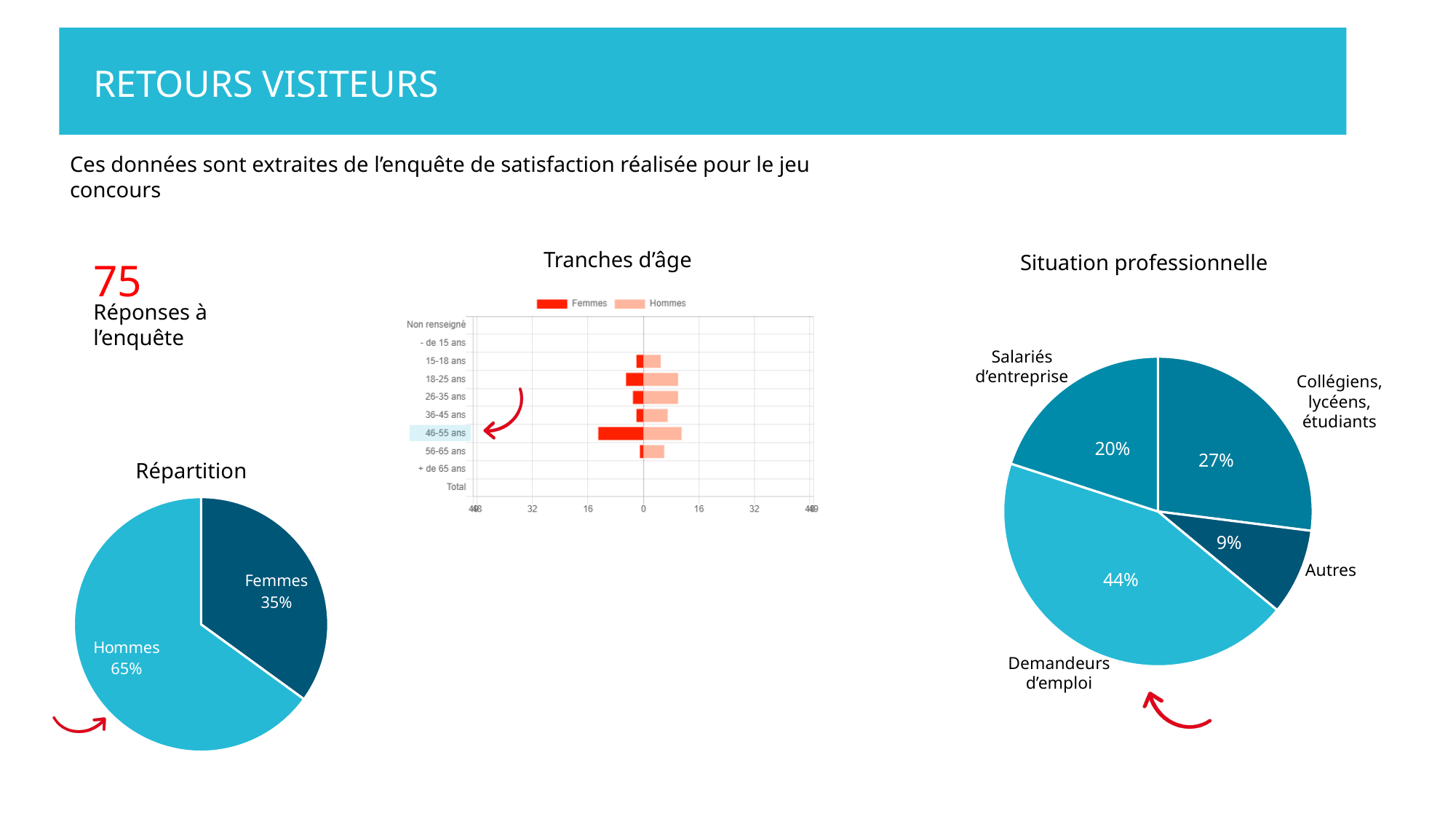
In the 'Tranches d'âge' chart, how many series does the legend list? 2 In the 'Situation professionnelle' pie chart, which category has the smallest share? Autres In the 'Répartition' pie chart, what percentage is shown for Femmes? 35% In the 'Situation professionnelle' pie chart, what percentage is shown for Salariés d'entreprise? 20% In the 'Tranches d'âge' chart, which age group has the largest Femmes bar? 46-55 ans What kind of chart is the 'Tranches d'âge' chart? Bar chart In the 'Répartition' pie chart, what percentage is shown for Hommes? 65% In the 'Situation professionnelle' pie chart, how many slices are there? 4 In the 'Situation professionnelle' pie chart, which is larger: Collégiens, lycéens, étudiants or Salariés d'entreprise? Collégiens, lycéens, étudiants In the 'Situation professionnelle' pie chart, what percentage is shown for Demandeurs d'emploi? 44% In the 'Répartition' pie chart, what is the difference in percentage points between Hommes and Femmes? 30 In the 'Situation professionnelle' pie chart, which category has the largest share? Demandeurs d'emploi